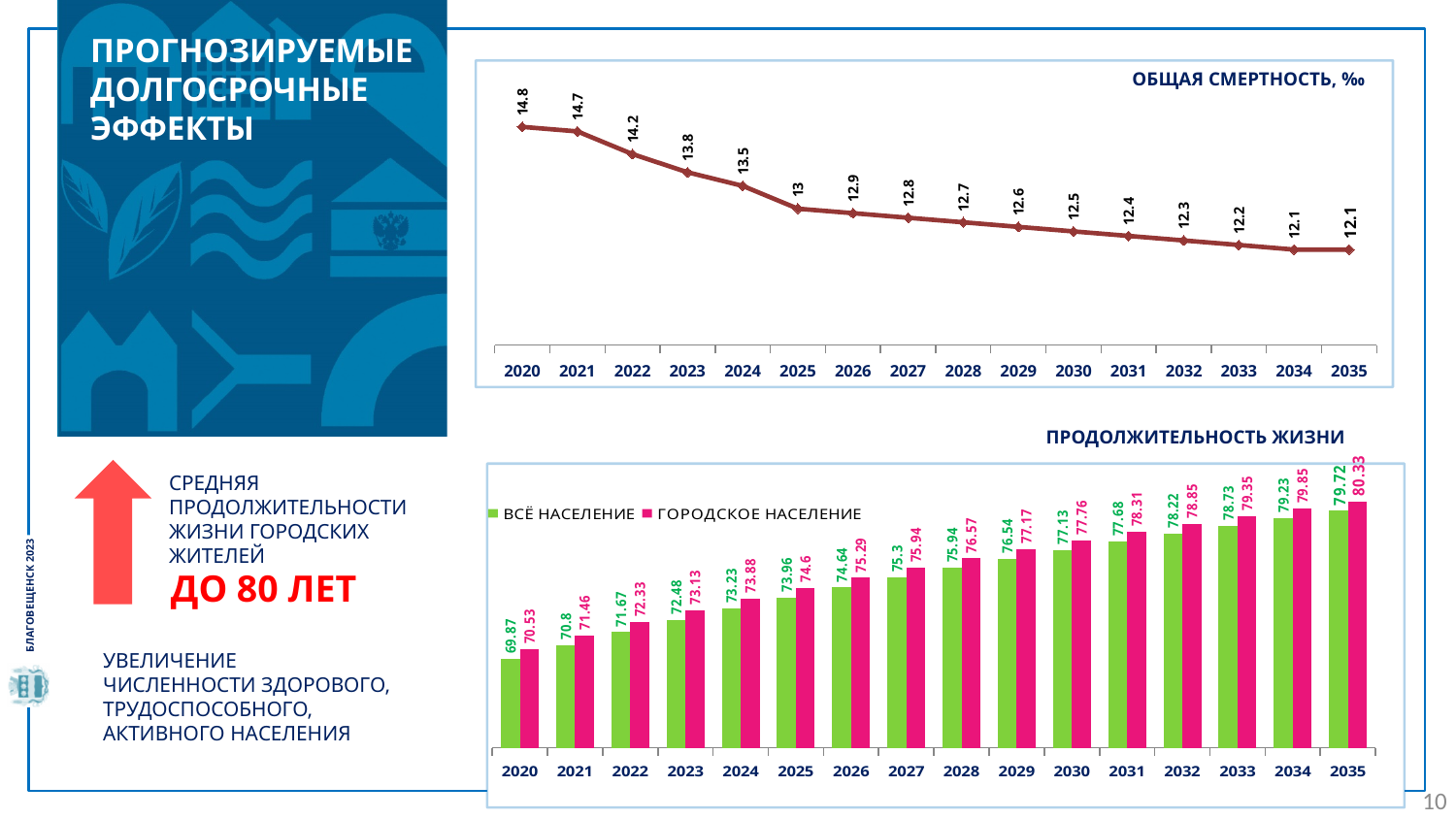
In the chart titled 'ПРОДОЛЖИТЕЛЬНОСТЬ ЖИЗНИ', what is the value for ВСЁ НАСЕЛЕНИЕ in 2020? 69.87 In the chart titled 'ПРОДОЛЖИТЕЛЬНОСТЬ ЖИЗНИ', what is the value for ГОРОДСКОЕ НАСЕЛЕНИЕ in 2035? 80.33 In the chart titled 'ПРОДОЛЖИТЕЛЬНОСТЬ ЖИЗНИ', how many years are shown on the x axis? 16 What kind of chart is the chart titled 'ОБЩАЯ СМЕРТНОСТЬ, ‰'? line chart In the chart titled 'ПРОДОЛЖИТЕЛЬНОСТЬ ЖИЗНИ', which is larger in 2030: ВСЁ НАСЕЛЕНИЕ or ГОРОДСКОЕ НАСЕЛЕНИЕ? ГОРОДСКОЕ НАСЕЛЕНИЕ In the chart titled 'ОБЩАЯ СМЕРТНОСТЬ, ‰', what is the value for 2025? 13 What kind of chart is the chart titled 'ПРОДОЛЖИТЕЛЬНОСТЬ ЖИЗНИ'? bar chart In the chart titled 'ОБЩАЯ СМЕРТНОСТЬ, ‰', which year has the highest value? 2020 In the chart titled 'ОБЩАЯ СМЕРТНОСТЬ, ‰', what is the value for 2020? 14.8 In the chart titled 'ОБЩАЯ СМЕРТНОСТЬ, ‰', do the values rise or fall from 2020 to 2035? fall In the chart titled 'ПРОДОЛЖИТЕЛЬНОСТЬ ЖИЗНИ', how many series does the legend list? 2 In the chart titled 'ОБЩАЯ СМЕРТНОСТЬ, ‰', what is the difference between the values for 2020 and 2035? 2.7